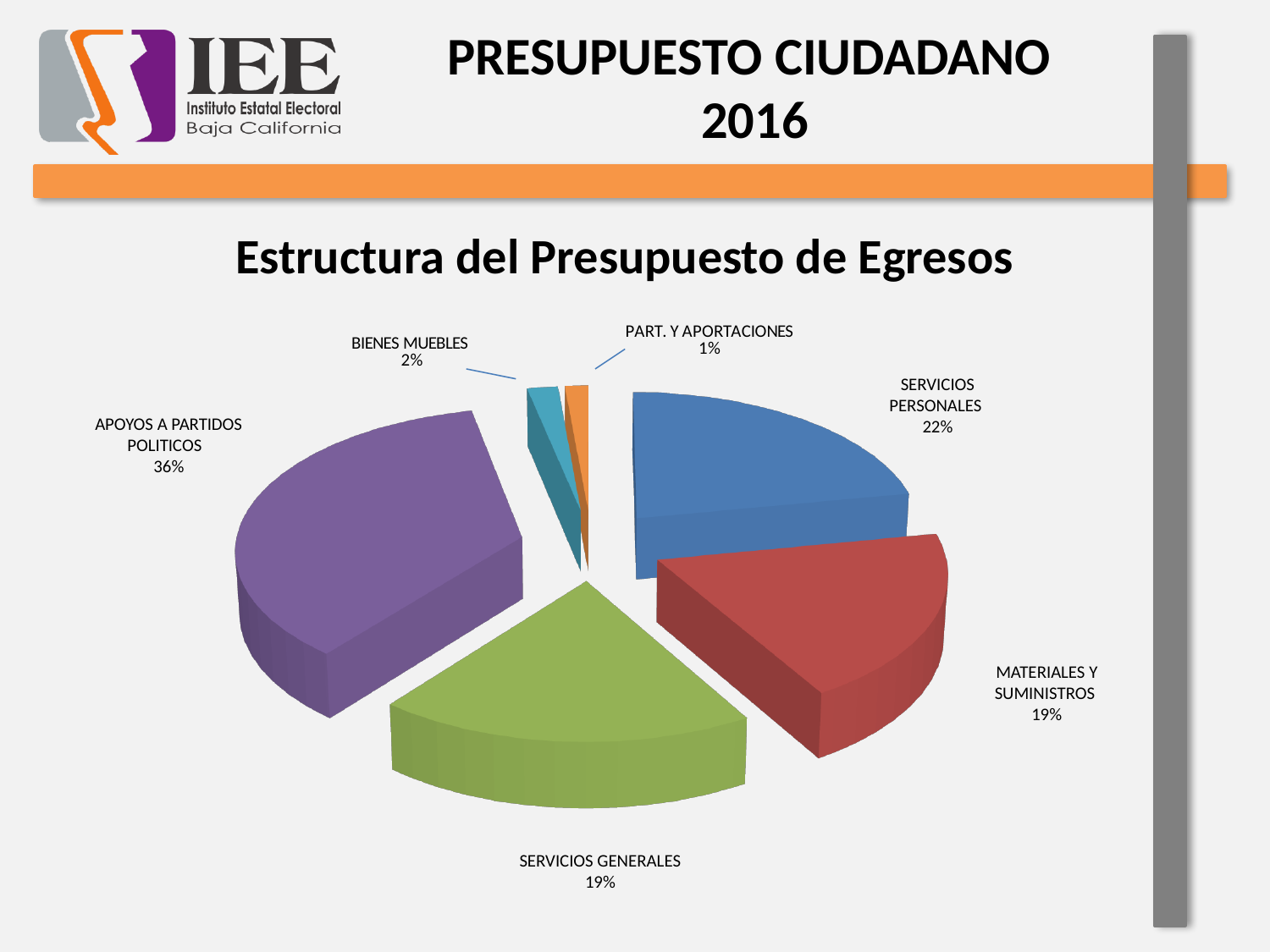
What type of chart is shown on the slide? Pie chart What share of the pie does APOYOS A PARTIDOS POLITICOS represent? 36% What is the difference in percentage points between APOYOS A PARTIDOS POLITICOS and SERVICIOS PERSONALES? 14 Which is larger, SERVICIOS PERSONALES or MATERIALES Y SUMINISTROS? SERVICIOS PERSONALES What percentage is shown for BIENES MUEBLES? 2% How many categories are shown in the pie chart? 6 Which category has the largest slice of the pie? APOYOS A PARTIDOS POLITICOS What is the title of the chart? Estructura del Presupuesto de Egresos What colour is the slice for APOYOS A PARTIDOS POLITICOS? Purple What percentage is shown for SERVICIOS PERSONALES? 22% Which category has the smallest slice of the pie? PART. Y APORTACIONES What percentage is shown for PART. Y APORTACIONES? 1%